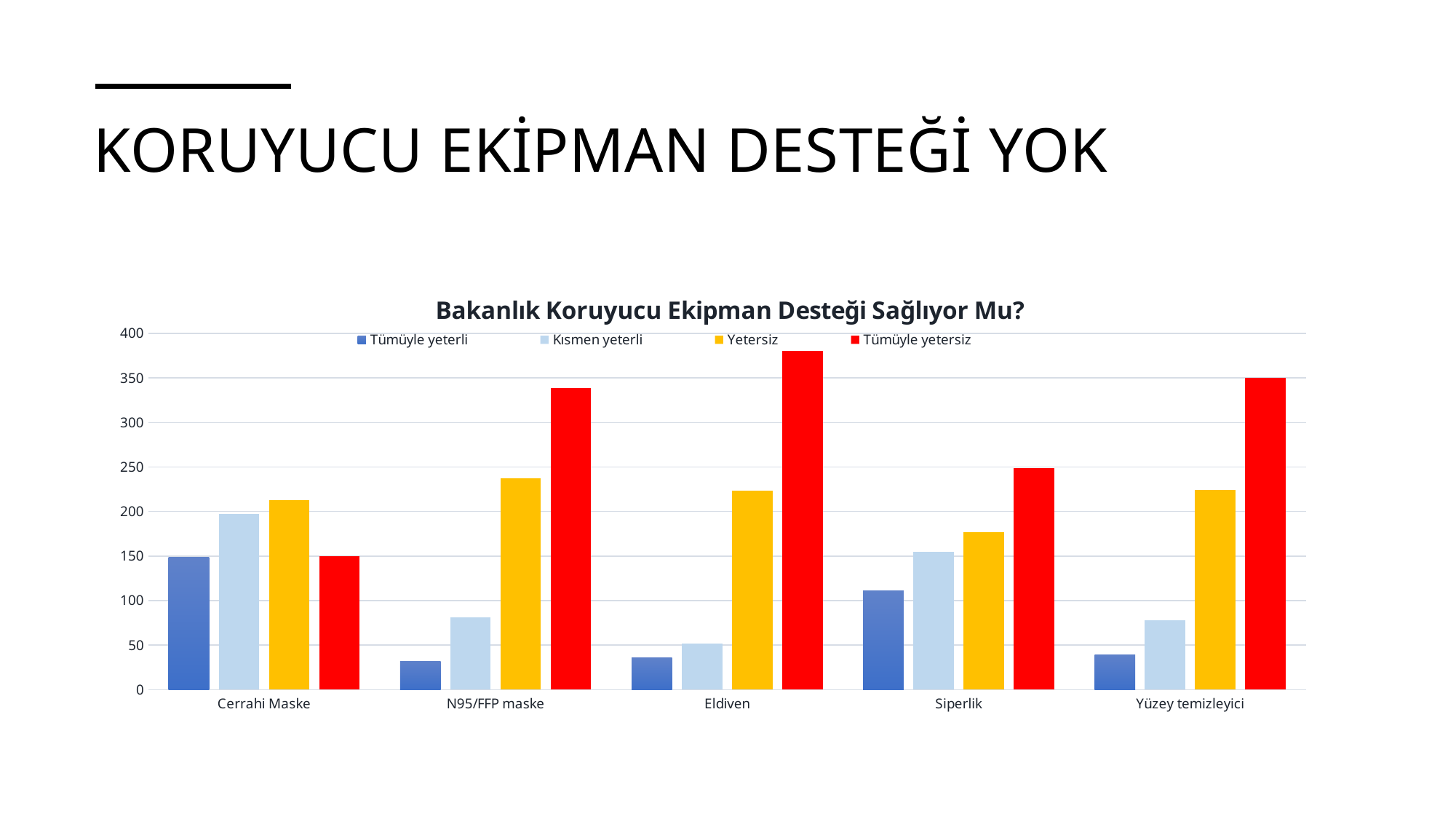
Is the Tümüyle yetersiz value for Eldiven greater or less than 350? greater For Cerrahi Maske, which is larger: the Kısmen yeterli value or the Tümüyle yetersiz value? Kısmen yeterli Which has the larger Tümüyle yetersiz value: Siperlik or N95/FFP maske? N95/FFP maske Is the Yetersiz value for Siperlik greater or less than 200? less How many series does the chart's legend list? 4 Which category has the highest value for the Tümüyle yetersiz series? Eldiven What kind of chart is shown on the slide? bar chart Which category has the lowest value for the Tümüyle yetersiz series? Cerrahi Maske What is the title of the chart? Bakanlık Koruyucu Ekipman Desteği Sağlıyor Mu? Is the Tümüyle yeterli value for Siperlik greater or less than 100? greater How many categories are shown on the x axis of the chart? 5 Which category has the highest value for the Tümüyle yeterli series? Cerrahi Maske